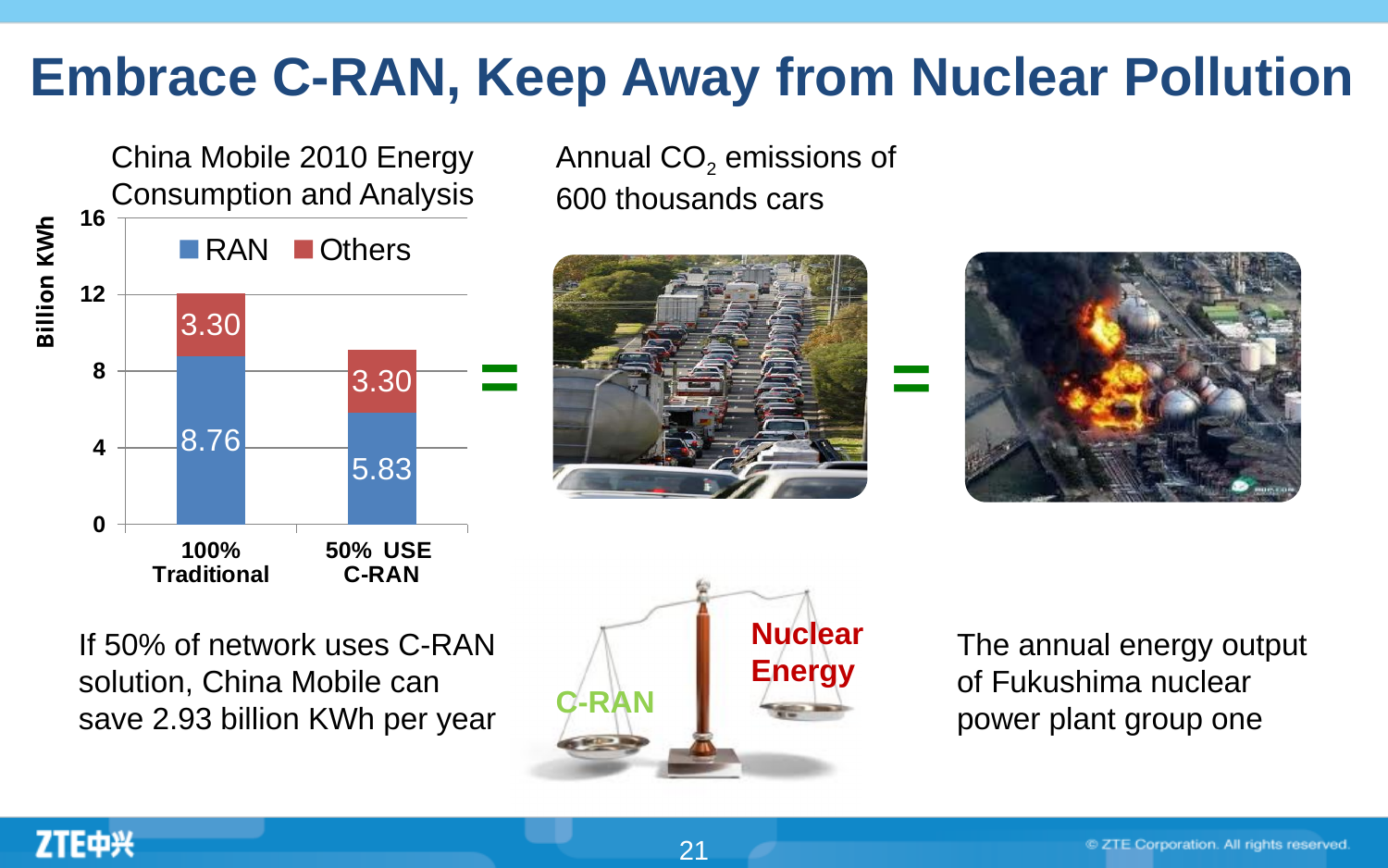
How many categories are shown on the x axis of the chart? 2 Which category has the higher RAN value? 100% Traditional Is the RAN value for 100% Traditional larger or smaller than the RAN value for 50% USE C-RAN? larger What is the Others value for the 100% Traditional category? 3.30 What is the total of the stacked bar for 100% Traditional? 12.06 What is the difference between the RAN values for 100% Traditional and 50% USE C-RAN? 2.93 What is the RAN value for the 100% Traditional category? 8.76 What is the Others value for the 50% USE C-RAN category? 3.30 What is the RAN value for the 50% USE C-RAN category? 5.83 What is the label of the chart's y axis? Billion KWh How many series does the chart legend list? 2 What is the total of the stacked bar for 50% USE C-RAN? 9.13